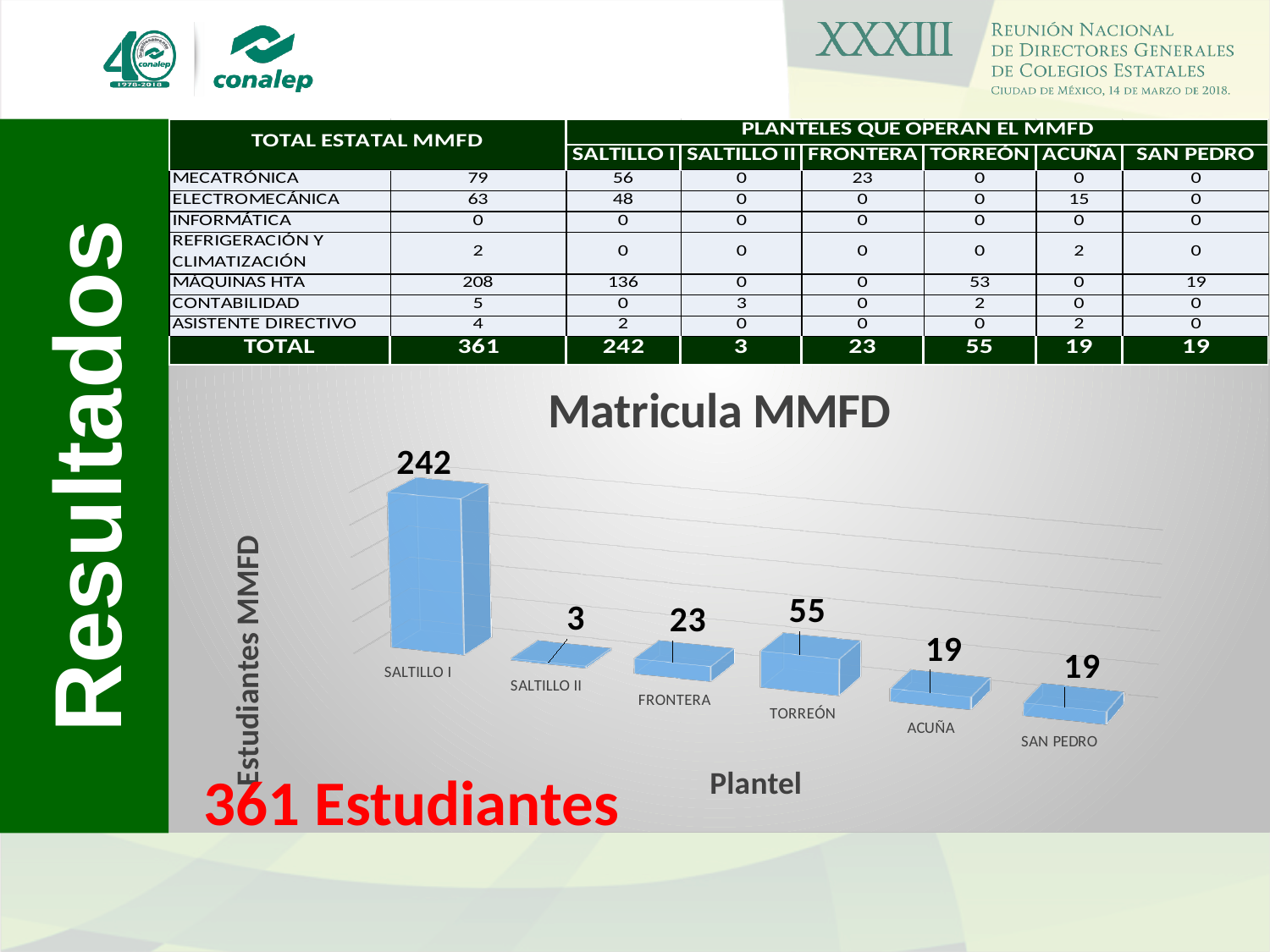
Which plantel has the lowest value in the Matricula MMFD chart? SALTILLO II What is the label of the vertical axis in the Matricula MMFD chart? Estudiantes MMFD In the Matricula MMFD chart, which is larger, the value for TORREÓN or the value for FRONTERA? TORREÓN What is the difference between the values for TORREÓN and FRONTERA in the Matricula MMFD chart? 32 How many planteles are shown in the Matricula MMFD chart? 6 What is the value for TORREÓN in the Matricula MMFD chart? 55 What is the value for SALTILLO II in the Matricula MMFD chart? 3 Which plantel has the highest value in the Matricula MMFD chart? SALTILLO I What is the value for FRONTERA in the Matricula MMFD chart? 23 What is the value for SALTILLO I in the Matricula MMFD chart? 242 What kind of chart is the Matricula MMFD chart? Bar chart What is the difference between the values for SALTILLO I and TORREÓN in the Matricula MMFD chart? 187